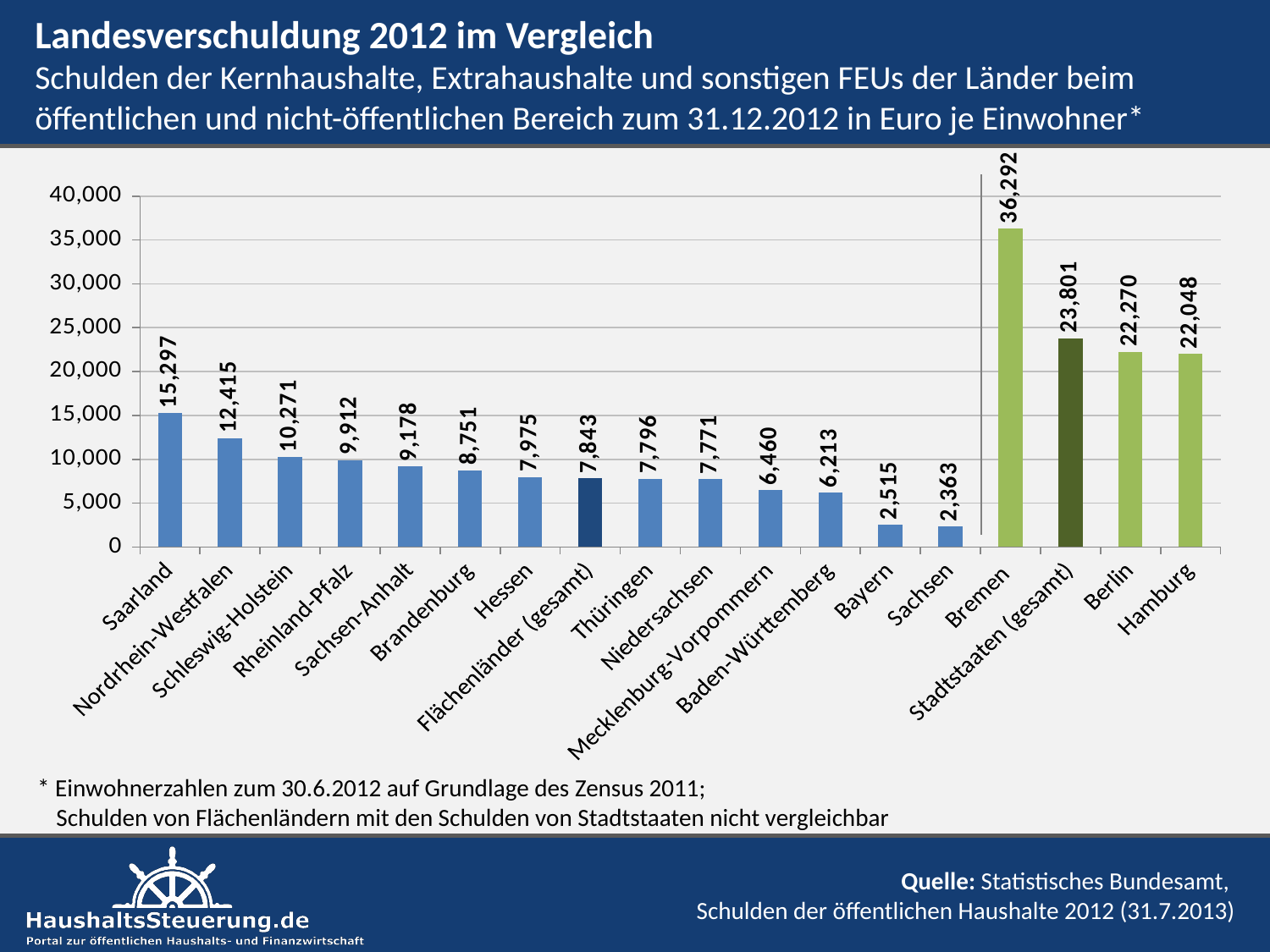
What is the value for Saarland? 15,297 What kind of chart is shown on the slide? bar chart What is the value for Hamburg? 22,048 Which category has the highest value? Bremen How many categories are shown on the x axis? 18 Which category has the lowest value? Sachsen What is the value for Flächenländer (gesamt)? 7,843 What is the value for Bremen? 36,292 Which has the larger value, Nordrhein-Westfalen or Schleswig-Holstein? Nordrhein-Westfalen Is the value for Berlin greater or less than 20,000? greater What is the difference between the values for Bremen and Stadtstaaten (gesamt)? 12,491 What is the title of the chart? Landesverschuldung 2012 im Vergleich